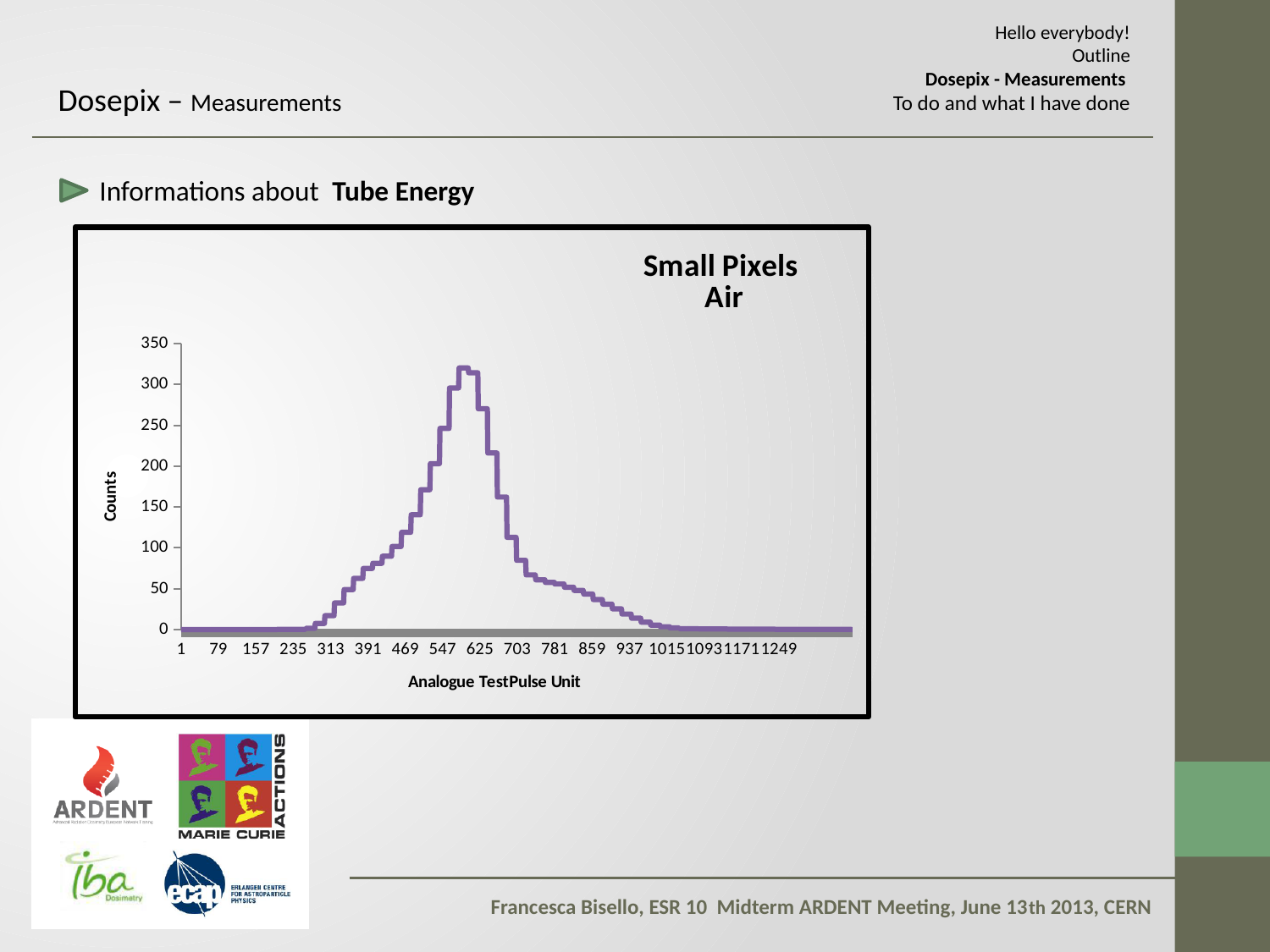
What is the highest tick value shown on the Counts axis? 350 Is the value of the curve at x = 1 greater or less than 50? less Is the value of the curve at x = 781 greater or less than 100? less Does the curve rise or fall between x = 625 and x = 781? fall What is the label of the x axis of the chart? Analogue TestPulse Unit What kind of chart is shown on the slide? line chart Is the peak value of the curve greater or less than 350? less Which is larger, the value of the curve at x = 547 or at x = 937? x = 547 What is the title of the chart? Small Pixels Air